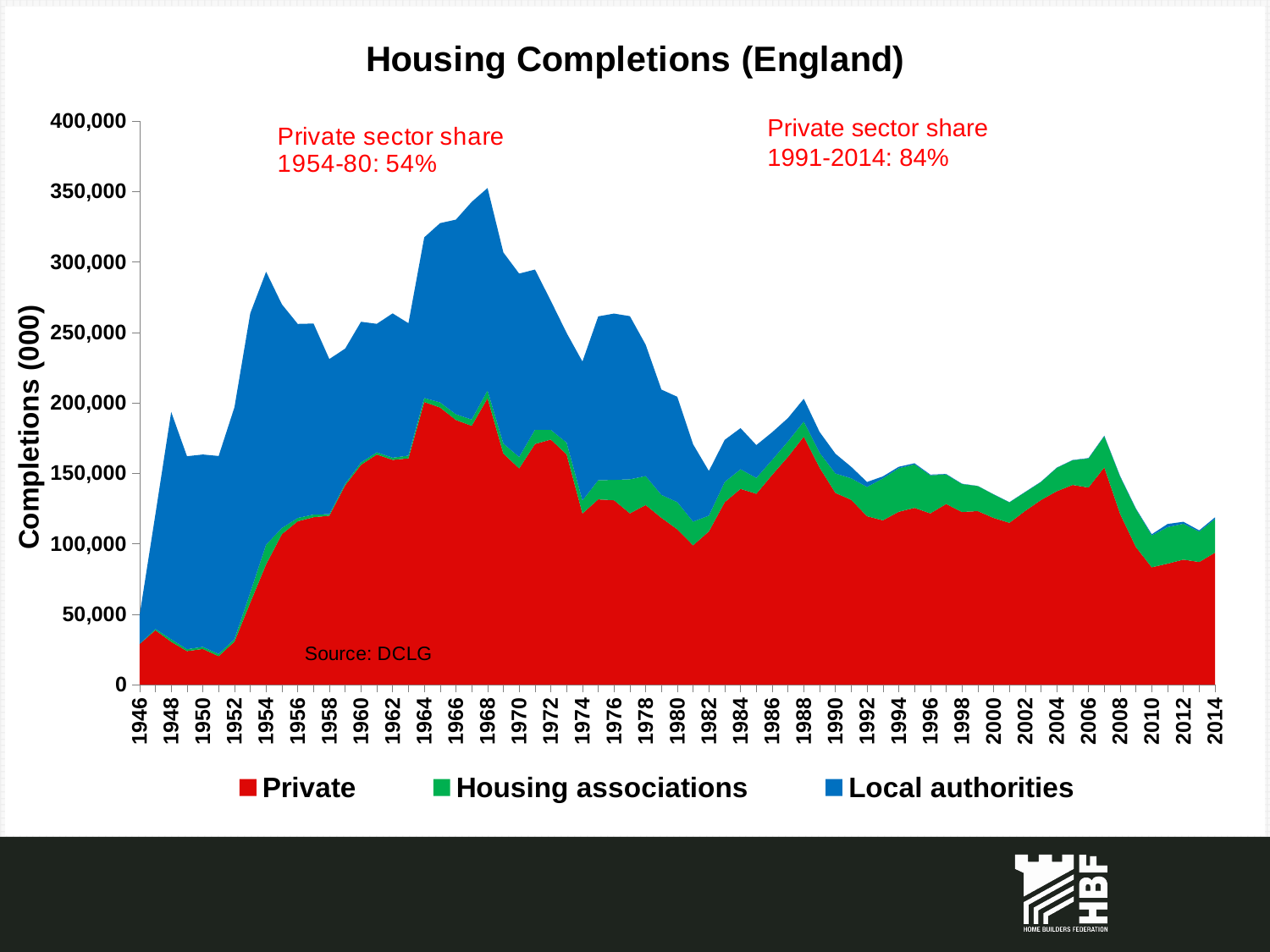
What kind of chart is shown on the slide? Stacked area chart Is the total housing completions value for 2010 greater or less than 150,000? less Do total housing completions rise or fall between 1946 and 1954? Rise Which series is shown in blue in the legend? Local authorities Is the total housing completions value for 1946 greater or less than 100,000? less How many series does the legend list? 3 Which year has the larger total housing completions, 1968 or 2014? 1968 What is the title of the chart? Housing Completions (England) Is the Private series value for 1964 greater or less than 150,000? greater In which year does the total of all three series reach its highest point? 1968 Do total housing completions rise or fall between 1968 and 1982? Fall